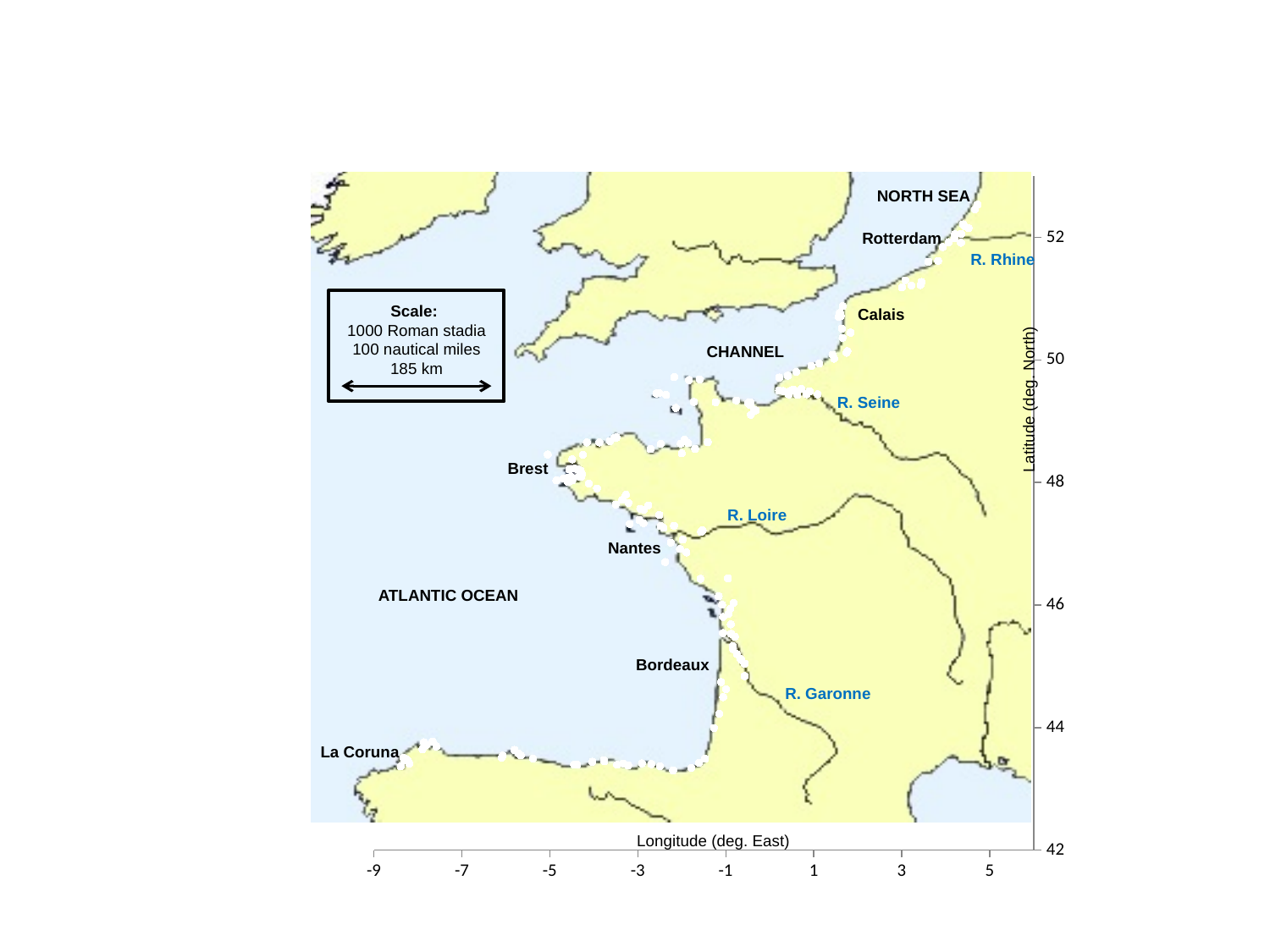
Is the latitude of Nantes greater or less than 48? less How many rivers are labelled on the map? 4 Is the longitude of La Coruna greater or less than -7? less Is the longitude of Rotterdam greater or less than 3? greater How many cities are labelled on the map? 6 Which labelled city is located furthest north? Rotterdam What is the title of the horizontal axis? Longitude (deg. East) According to the scale box, how many kilometres correspond to 1000 Roman stadia? 185 km